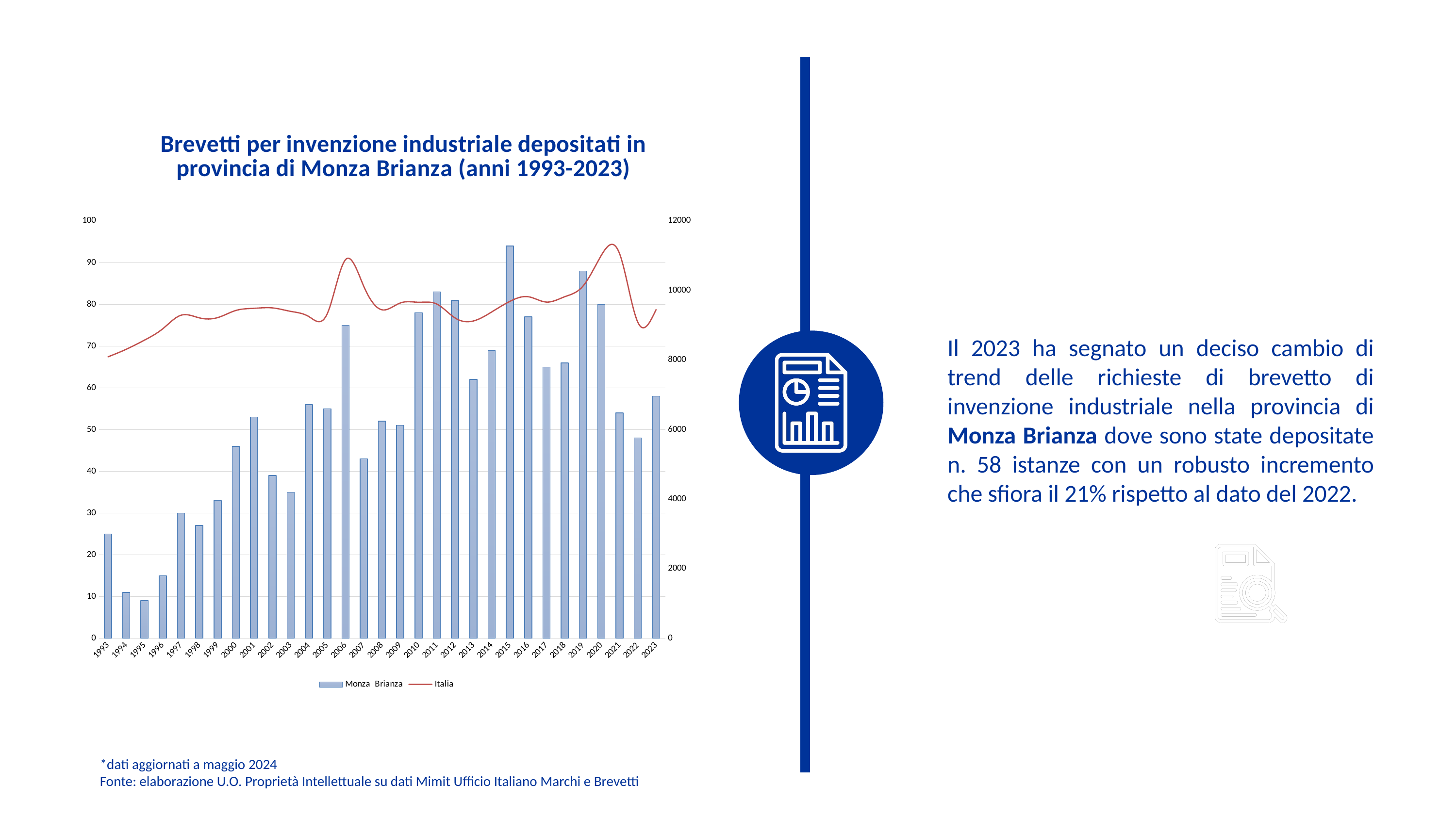
Is the Monza Brianza value for 2003 greater or less than 40? less What kind of chart is shown on the slide? bar chart with a line What are the two series named in the legend? Monza Brianza and Italia Do the Monza Brianza bars generally rise or fall from 1993 to 2001? rise In which year is the Monza Brianza bar lowest? 1995 Which year has the larger Monza Brianza bar, 2019 or 2020? 2019 Which year has the larger Monza Brianza bar, 1994 or 1996? 1996 Is the Monza Brianza value for 1993 greater or less than 20? greater How many series does the legend list? 2 How many years are shown on the x axis? 31 In which year is the Monza Brianza bar highest? 2015 Is the Monza Brianza value for 2006 greater or less than 70? greater